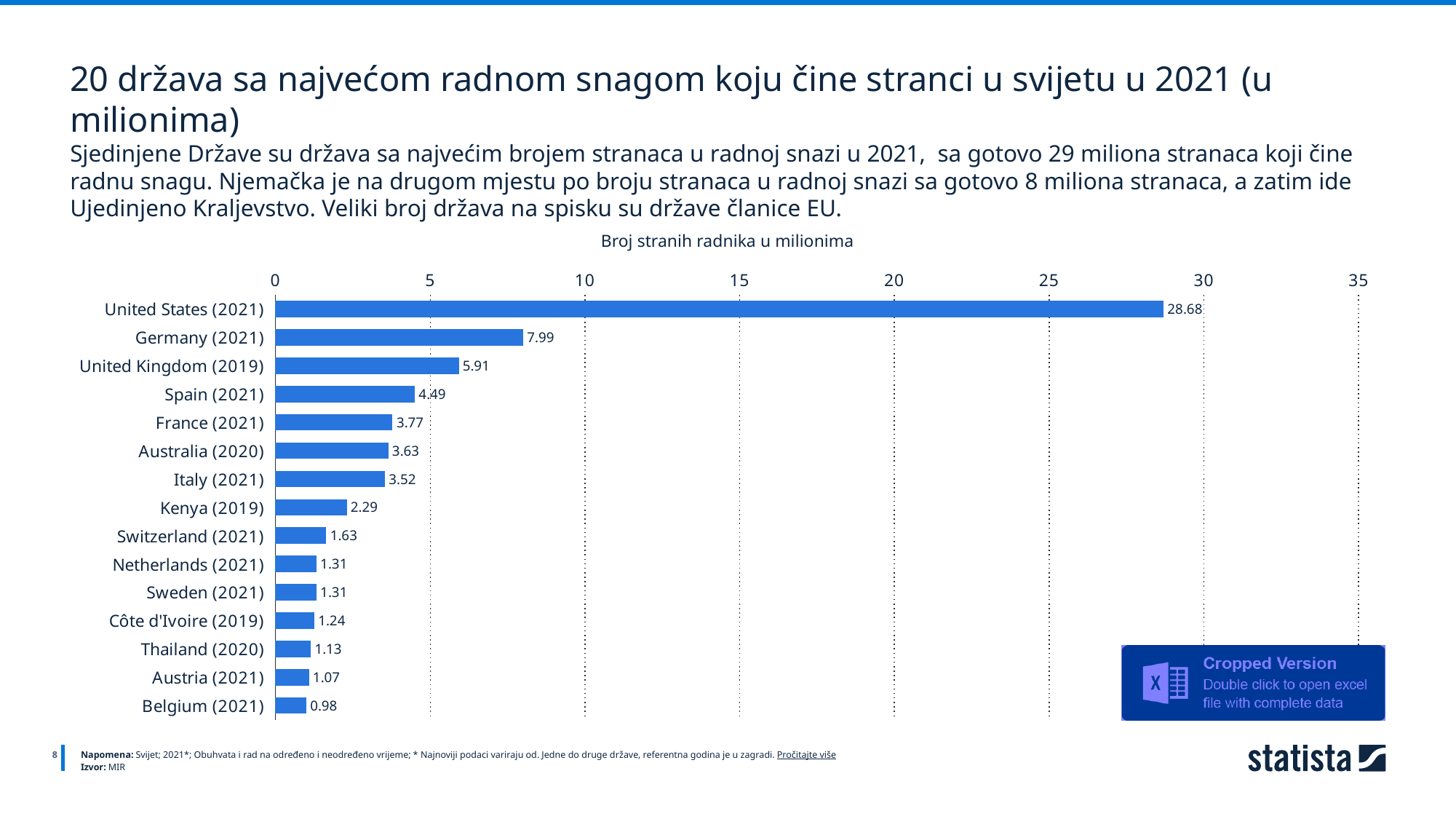
What type of chart is shown on the slide? bar chart What is the value for United States (2021)? 28.68 What is the value for Belgium (2021)? 0.98 What is the value for Kenya (2019)? 2.29 How many bars are plotted in the chart? 15 Which has a larger value, Australia (2020) or Italy (2021)? Australia (2020) What is the difference between the values for Spain (2021) and France (2021)? 0.72 Is the value for Germany (2021) greater or less than 10? less What is the value for Germany (2021)? 7.99 Which country has the highest number of foreign workers in the chart? United States (2021) Which country has the lowest value among the bars shown? Belgium (2021) What is the difference between the values for United States (2021) and Germany (2021)? 20.69